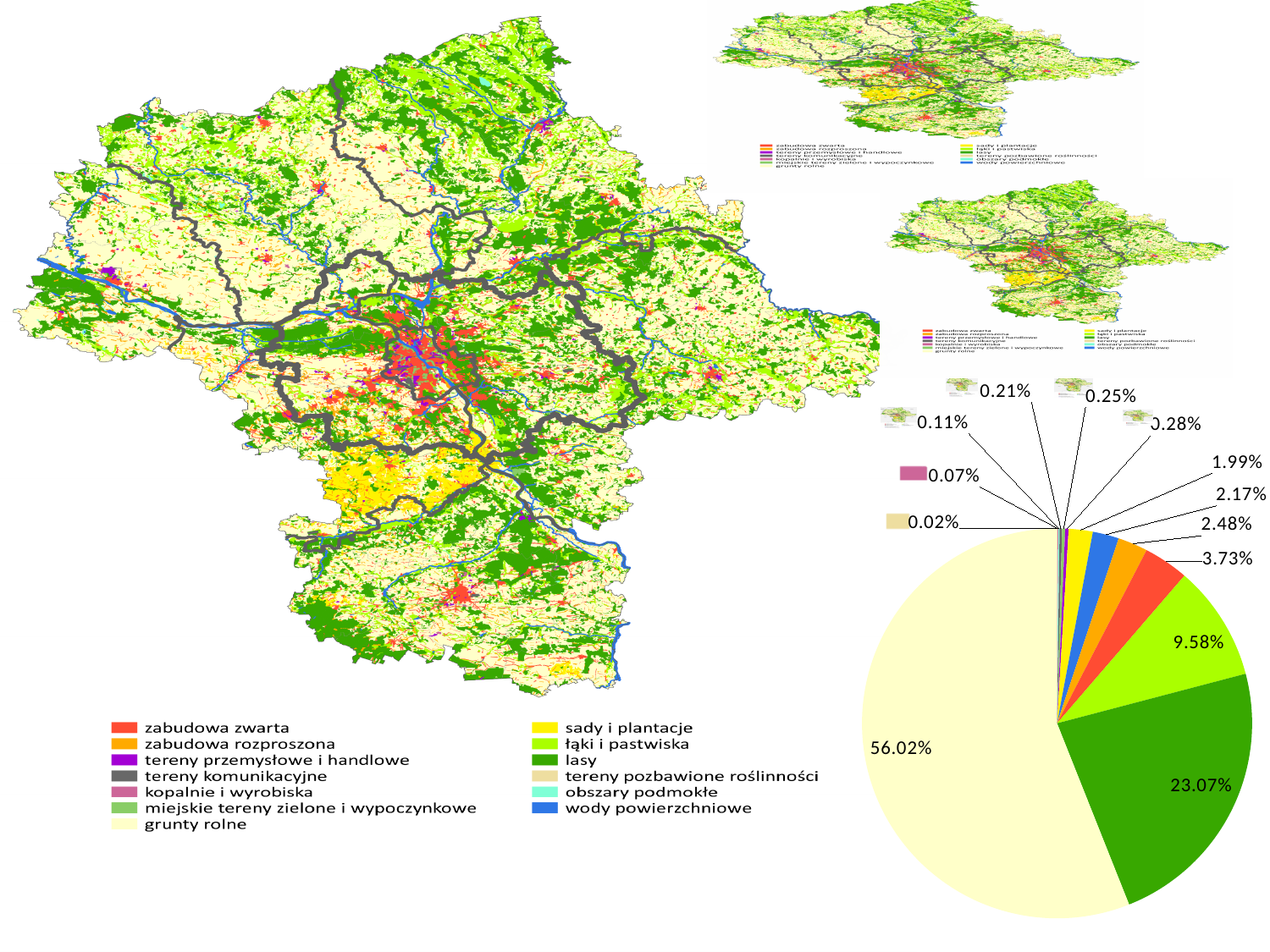
In the pie chart, what is the share of the orange slice? 2.48% How many slices with percentage labels does the pie chart have? 13 In the pie chart, what is the share of the largest slice? 56.02% In the pie chart, which is larger: the red slice or the orange slice? the red slice (3.73%) In the pie chart, is the share of the largest slice greater or less than 50%? greater In the pie chart, what is the share of the red slice? 3.73% In the pie chart, what is the share of the dark green slice? 23.07% In the pie chart, what is the difference between the largest slice (56.02%) and the dark green slice (23.07%)? 32.95% What kind of chart is shown on the right side of the slide? pie chart In the pie chart, what is the share of the blue slice? 2.17% In the pie chart, what is the share of the light green slice? 9.58% In the pie chart, what is the share of the smallest slice? 0.02%